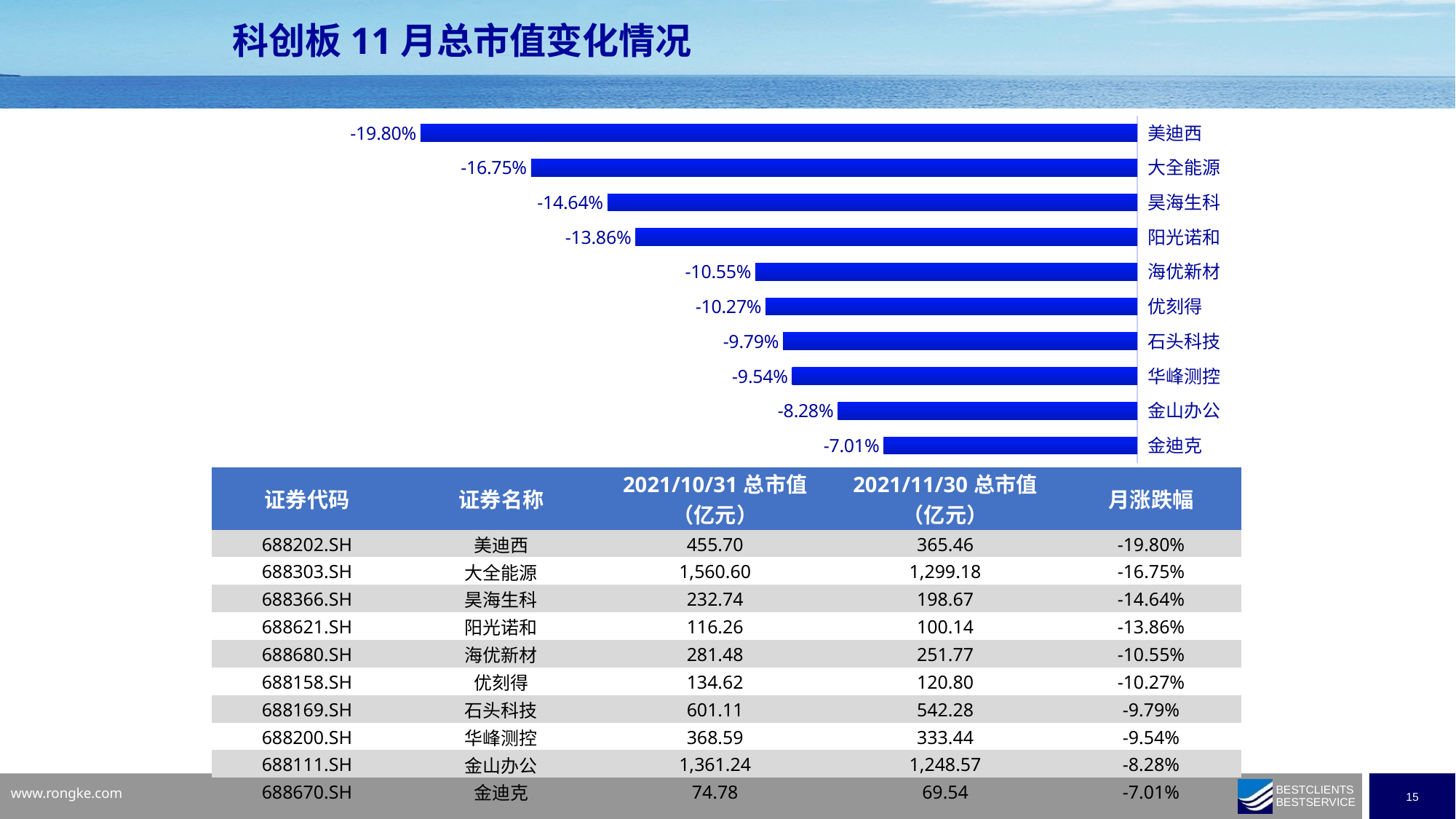
What is the title of the slide containing the chart? 科创板 11 月总市值变化情况 What is the difference in percentage points between the values for 大全能源 and 昊海生科 in the bar chart? 2.11 percentage points How many categories (bars) are shown in the bar chart? 10 What kind of chart is shown on the slide? Bar chart Which has a larger decline in the bar chart, 石头科技 or 华峰测控? 石头科技 What is the value shown for 海优新材 in the bar chart? -10.55% What is the value shown for 大全能源 in the bar chart? -16.75% What is the value shown for 金山办公 in the bar chart? -8.28% What is the difference in percentage points between the values for 美迪西 and 金迪克 in the bar chart? 12.79 percentage points Which category in the bar chart has the smallest decline (the least negative value)? 金迪克 What is the value shown for 美迪西 in the bar chart? -19.80% Which category in the bar chart has the largest decline (the most negative value)? 美迪西